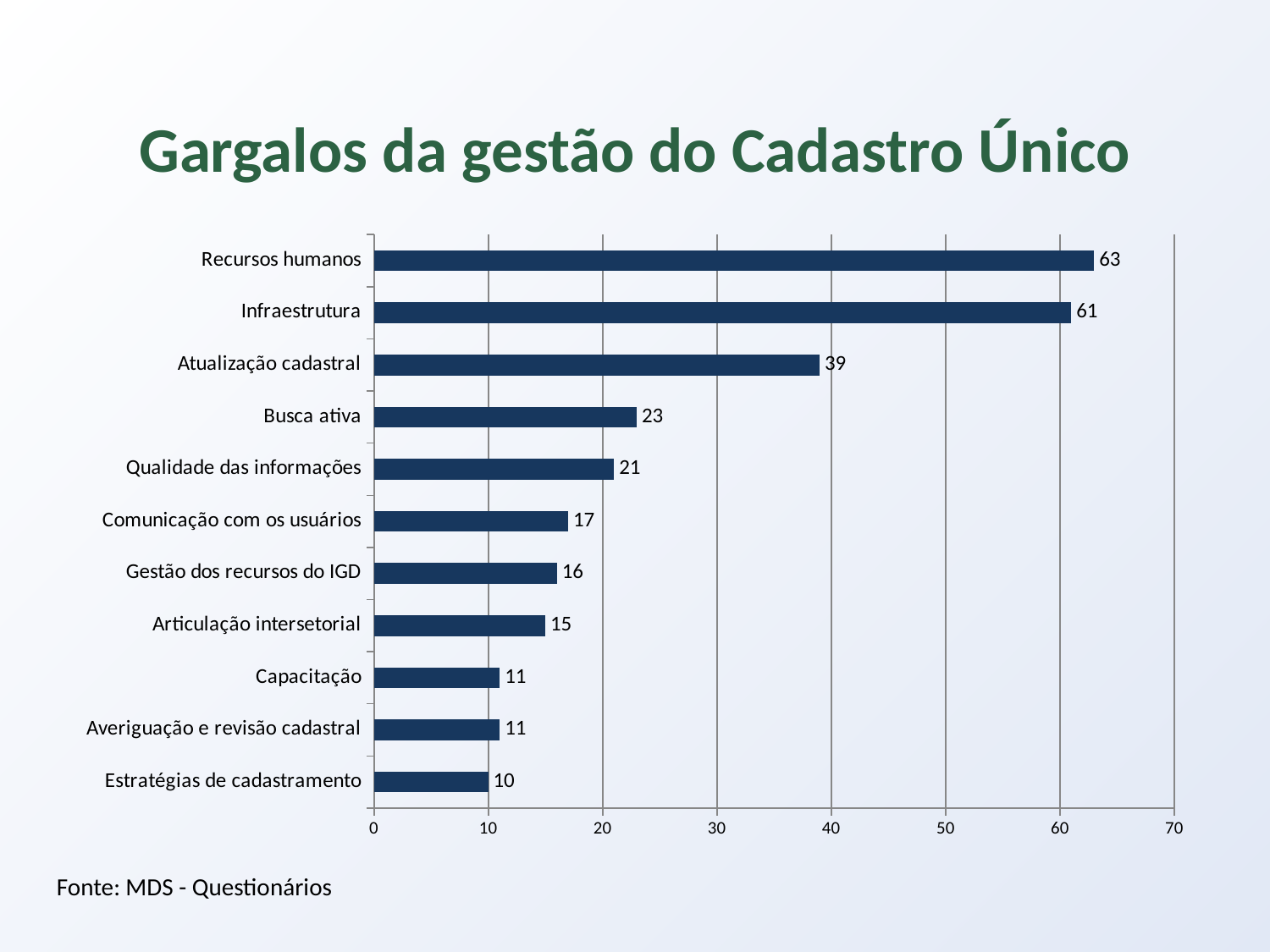
What is the difference between the values for Atualização cadastral and Busca ativa? 16 What is the value for Gestão dos recursos do IGD? 16 Which is larger, the value for Busca ativa or the value for Qualidade das informações? Busca ativa What kind of chart is shown on the slide? bar chart Which category has the highest value? Recursos humanos Which category has the lowest value? Estratégias de cadastramento What is the title of the slide? Gargalos da gestão do Cadastro Único Is the value for Comunicação com os usuários greater or less than 20? less What is the value for Atualização cadastral? 39 What is the difference between the values for Recursos humanos and Infraestrutura? 2 What is the value for Recursos humanos? 63 How many categories are shown in the chart? 11